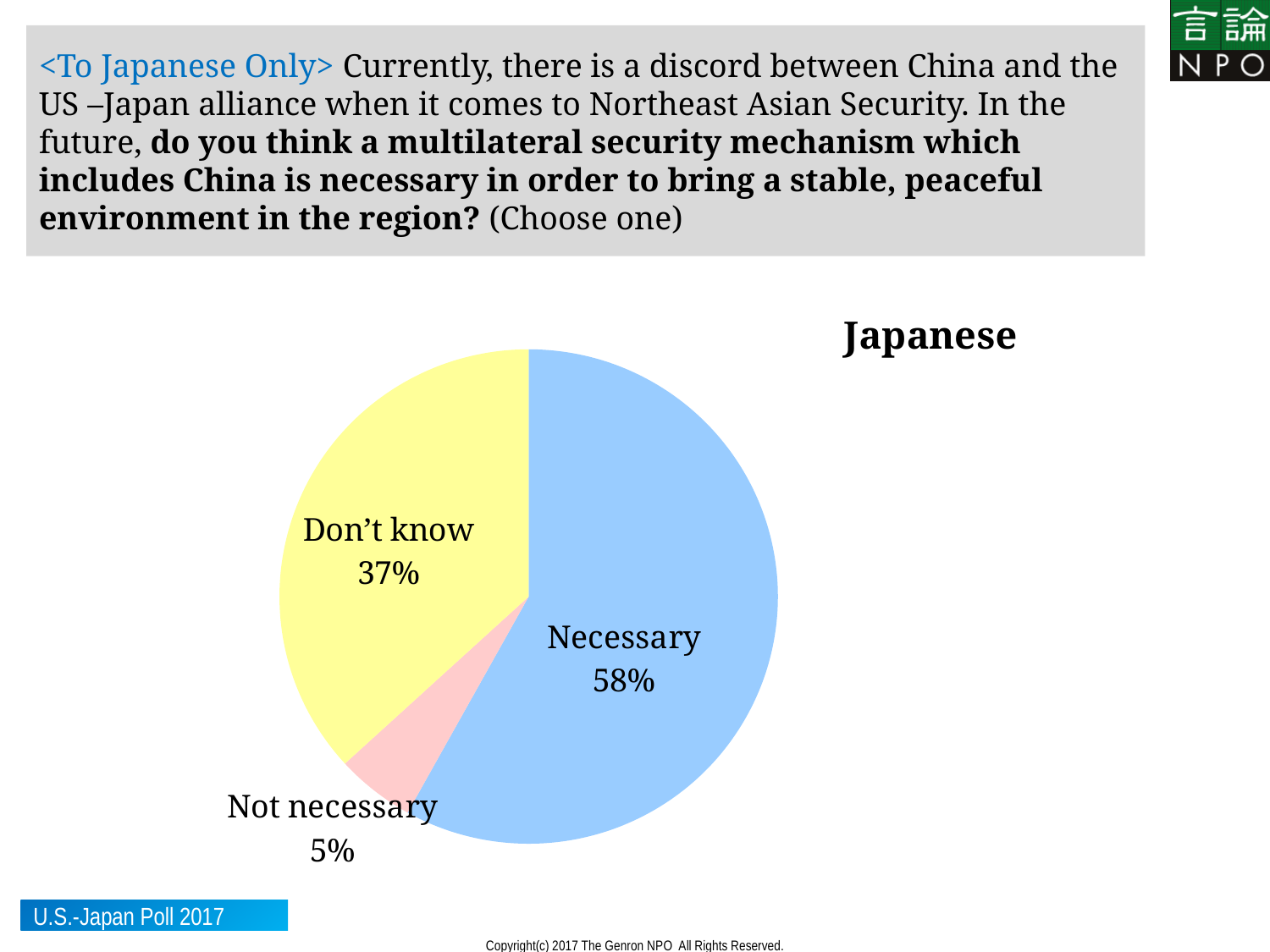
Which is larger, the share for "Don't know" or the share for "Not necessary"? Don't know What is the difference in percentage points between "Don't know" and "Not necessary"? 32 What percentage of Japanese respondents answered "Not necessary"? 5% How many slices does the pie chart have? 3 What kind of chart is shown on the slide? pie chart Which response has the largest share of the pie? Necessary What is the difference in percentage points between "Necessary" and "Don't know"? 21 Which group of respondents does the pie chart represent, according to the label next to it? Japanese What percentage of Japanese respondents answered "Necessary"? 58% What percentage of Japanese respondents answered "Don't know"? 37% Which response has the smallest share of the pie? Not necessary What colour is the "Necessary" slice? blue